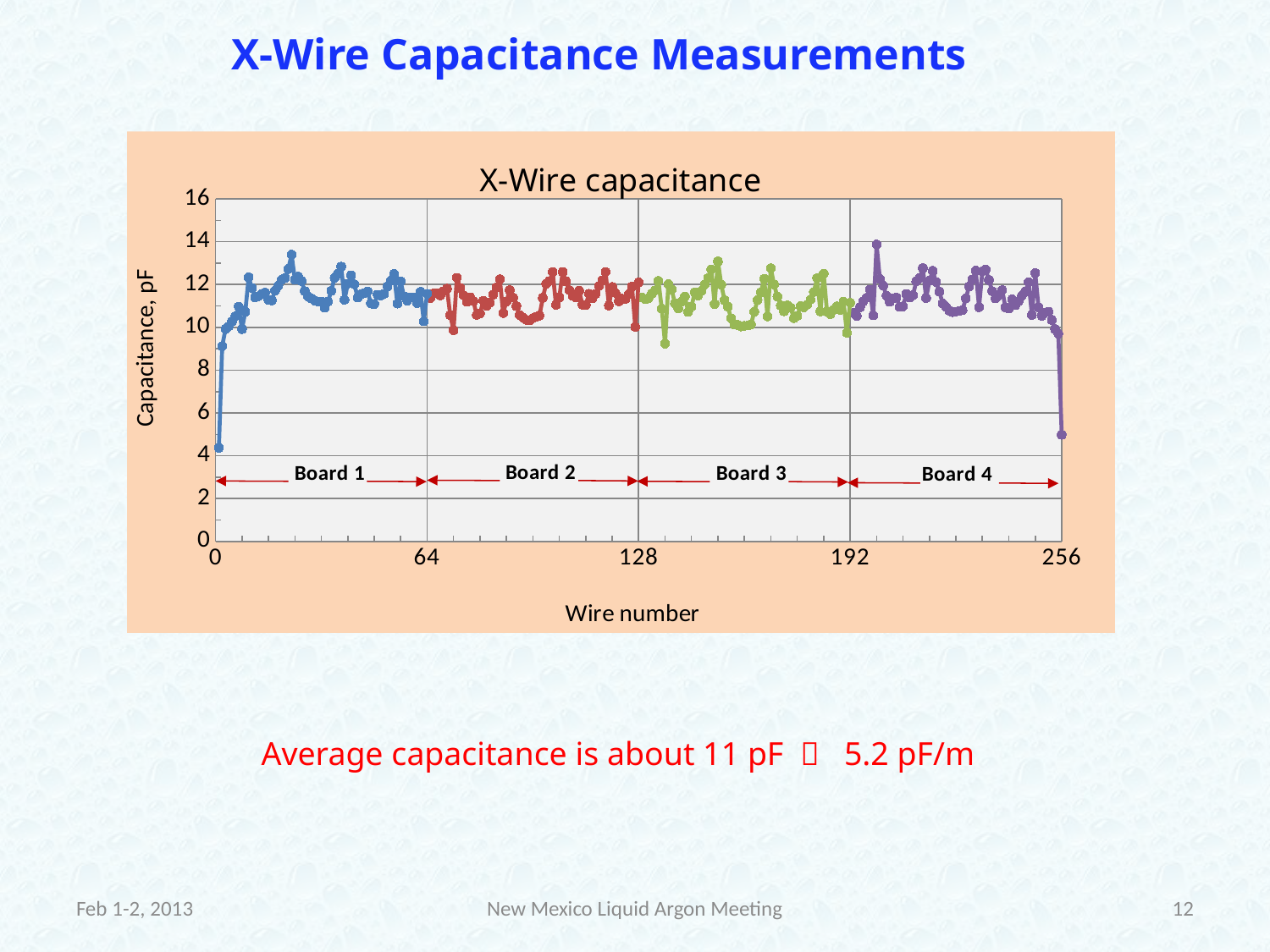
Is the capacitance value for wire number 64 greater or less than 8 pF? greater Is the highest capacitance value in the Board 1 region greater or less than 12 pF? greater What is the title of the chart? X-Wire capacitance Which wire number has the lowest capacitance value on the chart, wire 0 or wire 128? wire 0 What is the maximum value shown on the vertical axis of the chart? 16 What is the label of the vertical axis of the chart? Capacitance, pF Is the capacitance value for wire number 192 greater or less than 14 pF? less How many boards are marked along the x axis of the chart? 4 What kind of chart is shown on the slide? line chart